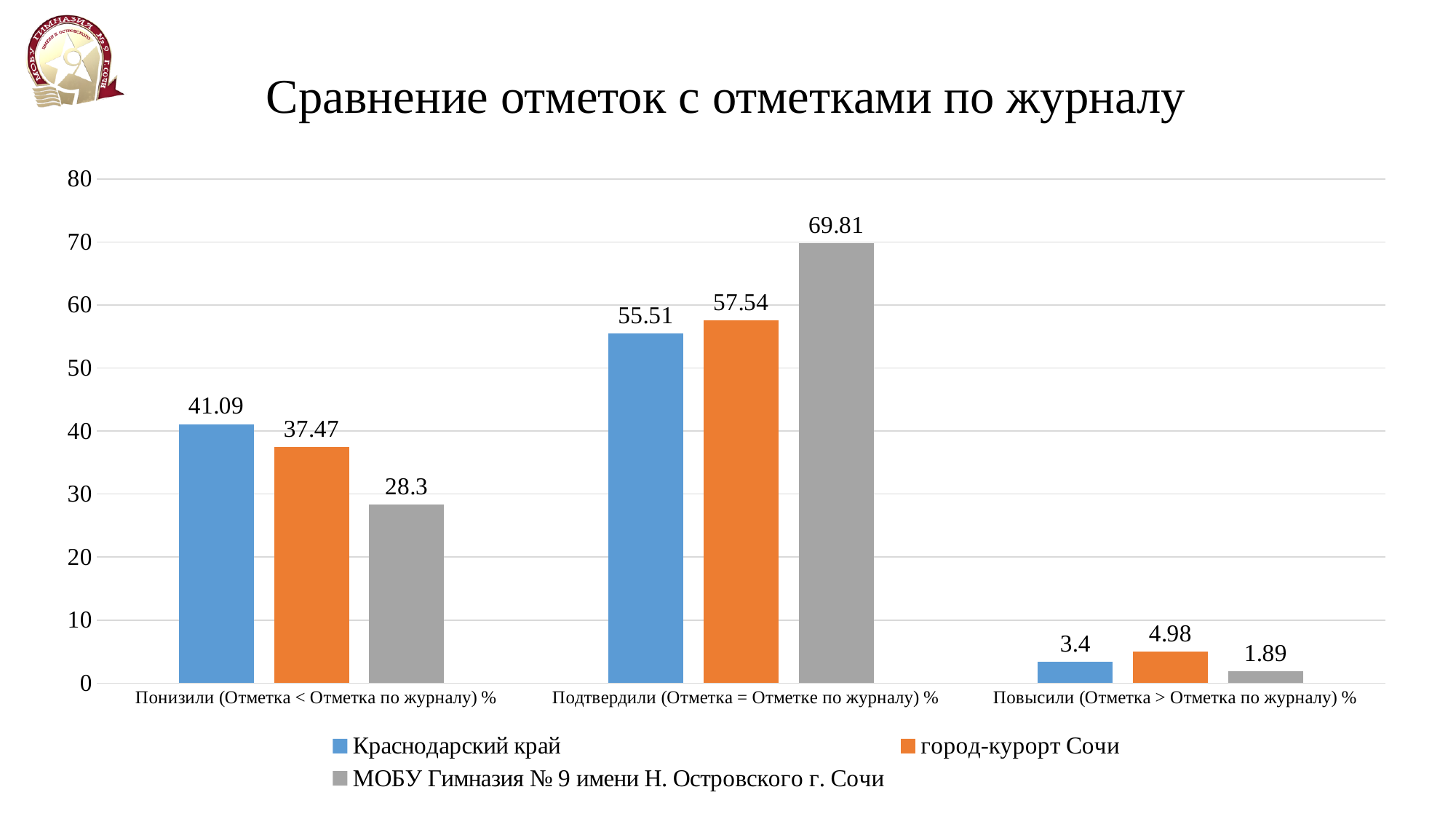
What is the difference between the МОБУ Гимназия № 9 value and the Краснодарский край value in the Подтвердили (Отметка = Отметке по журналу) % category? 14.3 What is the value for город-курорт Сочи in the Повысили (Отметка > Отметка по журналу) % category? 4.98 What kind of chart is shown on the slide? Bar chart How many categories are shown on the x axis? 3 What is the difference between the Краснодарский край value and the МОБУ Гимназия № 9 value in the Понизили (Отметка < Отметка по журналу) % category? 12.79 What is the value for МОБУ Гимназия № 9 имени Н. Островского г. Сочи in the Подтвердили (Отметка = Отметке по журналу) % category? 69.81 How many series does the legend list? 3 Which series has the lowest value in the Повысили (Отметка > Отметка по журналу) % category? МОБУ Гимназия № 9 имени Н. Островского г. Сочи Which series has the highest value in the Подтвердили (Отметка = Отметке по журналу) % category? МОБУ Гимназия № 9 имени Н. Островского г. Сочи What is the value for Краснодарский край in the Понизили (Отметка < Отметка по журналу) % category? 41.09 What is the title of the chart on the slide? Сравнение отметок с отметками по журналу In the Понизили (Отметка < Отметка по журналу) % category, which is larger: Краснодарский край or город-курорт Сочи? Краснодарский край